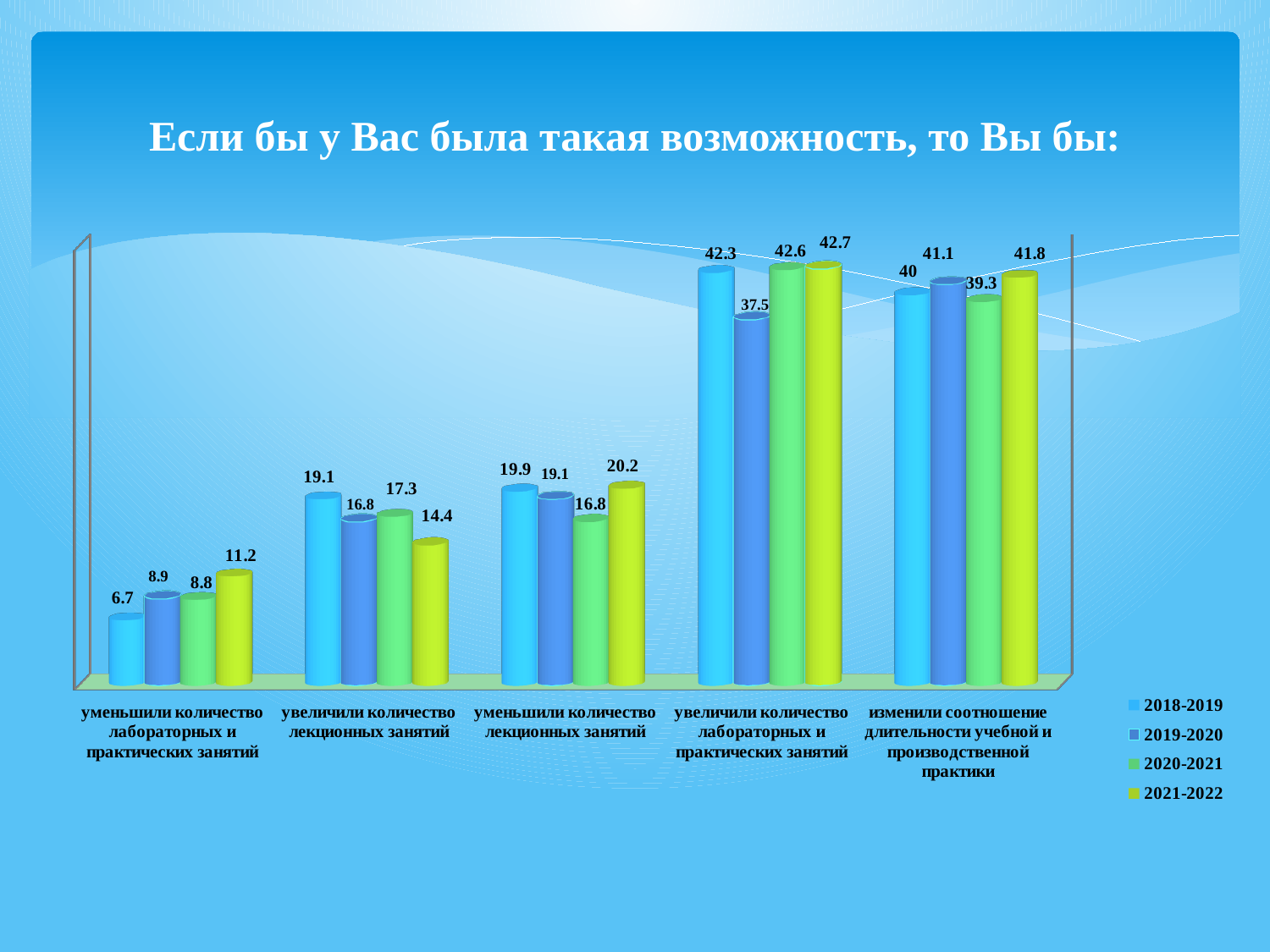
What is the difference between the 2021-2022 and 2018-2019 values in the category "уменьшили количество лабораторных и практических занятий"? 4.5 Which category has the highest value for the 2021-2022 series? увеличили количество лабораторных и практических занятий In the category "уменьшили количество лекционных занятий", which is larger: the 2018-2019 value or the 2020-2021 value? 2018-2019 What kind of chart is shown on the slide? bar chart What is the value for 2021-2022 in the category "увеличили количество лекционных занятий"? 14.4 Which category has the lowest value for the 2018-2019 series? уменьшили количество лабораторных и практических занятий How many series does the legend list? 4 What is the value for 2019-2020 in the category "увеличили количество лабораторных и практических занятий"? 37.5 What is the title of the slide above the chart? Если бы у Вас была такая возможность, то Вы бы: What is the value for 2020-2021 in the category "изменили соотношение длительности учебной и производственной практики"? 39.3 What is the value for 2018-2019 in the category "уменьшили количество лабораторных и практических занятий"? 6.7 How many categories are shown on the x axis of the chart? 5